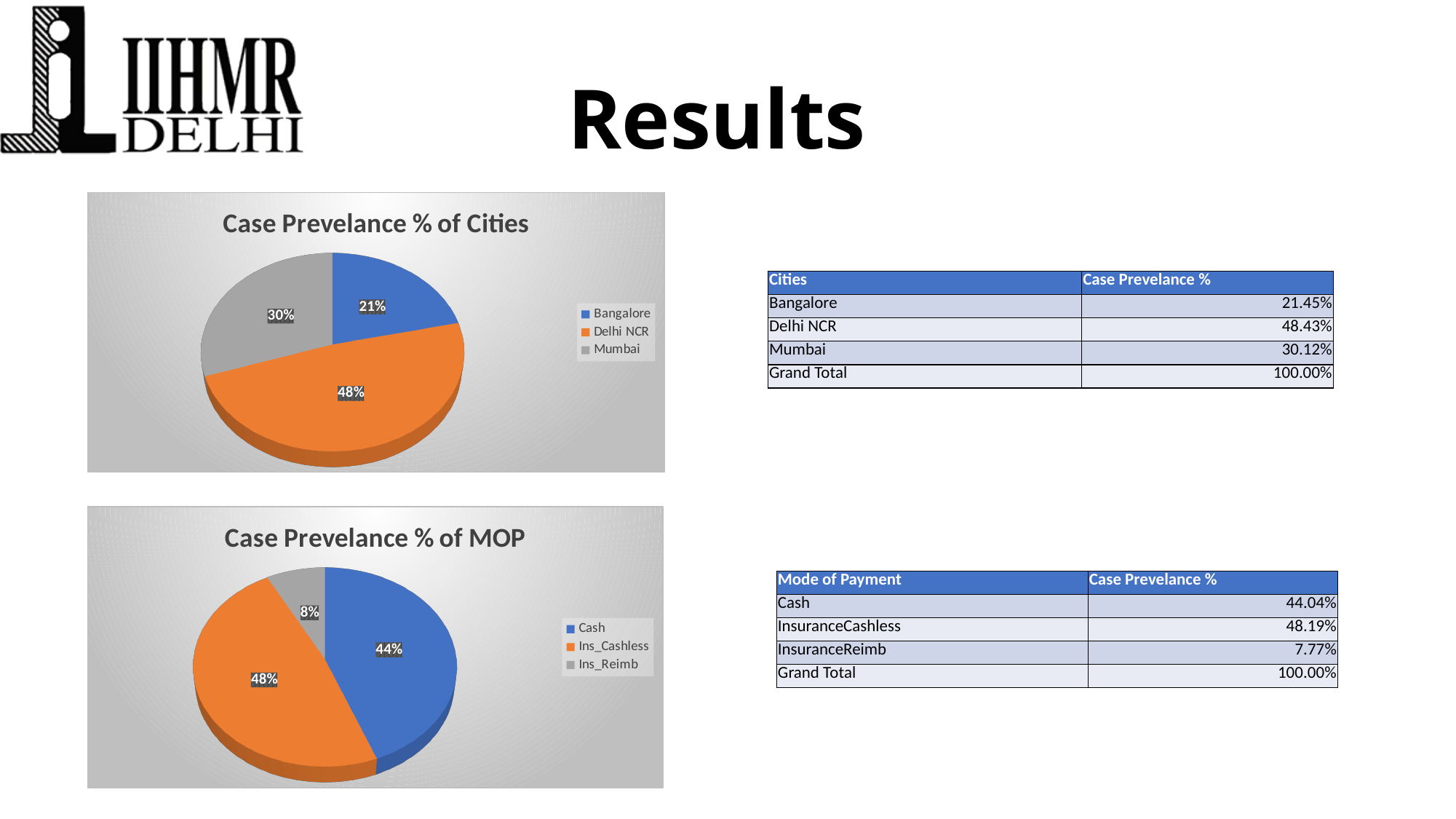
In the 'Case Prevelance % of MOP' chart, which mode of payment has the largest slice? Ins_Cashless In the 'Case Prevelance % of MOP' chart, which is larger, the Cash slice or the Ins_Cashless slice? Ins_Cashless In the 'Case Prevelance % of Cities' chart, what share is labelled for Delhi NCR? 48% In the 'Case Prevelance % of MOP' chart, what share is labelled for Ins_Reimb? 8% In the 'Case Prevelance % of MOP' chart, what colour is the Cash slice? Blue What kind of chart is 'Case Prevelance % of MOP'? Pie chart In the 'Case Prevelance % of Cities' chart, which city has the smallest slice? Bangalore In the 'Case Prevelance % of Cities' chart, which city has the largest slice? Delhi NCR In the 'Case Prevelance % of Cities' chart, what share is labelled for Bangalore? 21% In the 'Case Prevelance % of Cities' chart, how many cities are shown? 3 In the 'Case Prevelance % of Cities' chart, how many percentage points larger is the Delhi NCR slice than the Bangalore slice? 27 percentage points In the 'Case Prevelance % of MOP' chart, what share is labelled for Cash? 44%